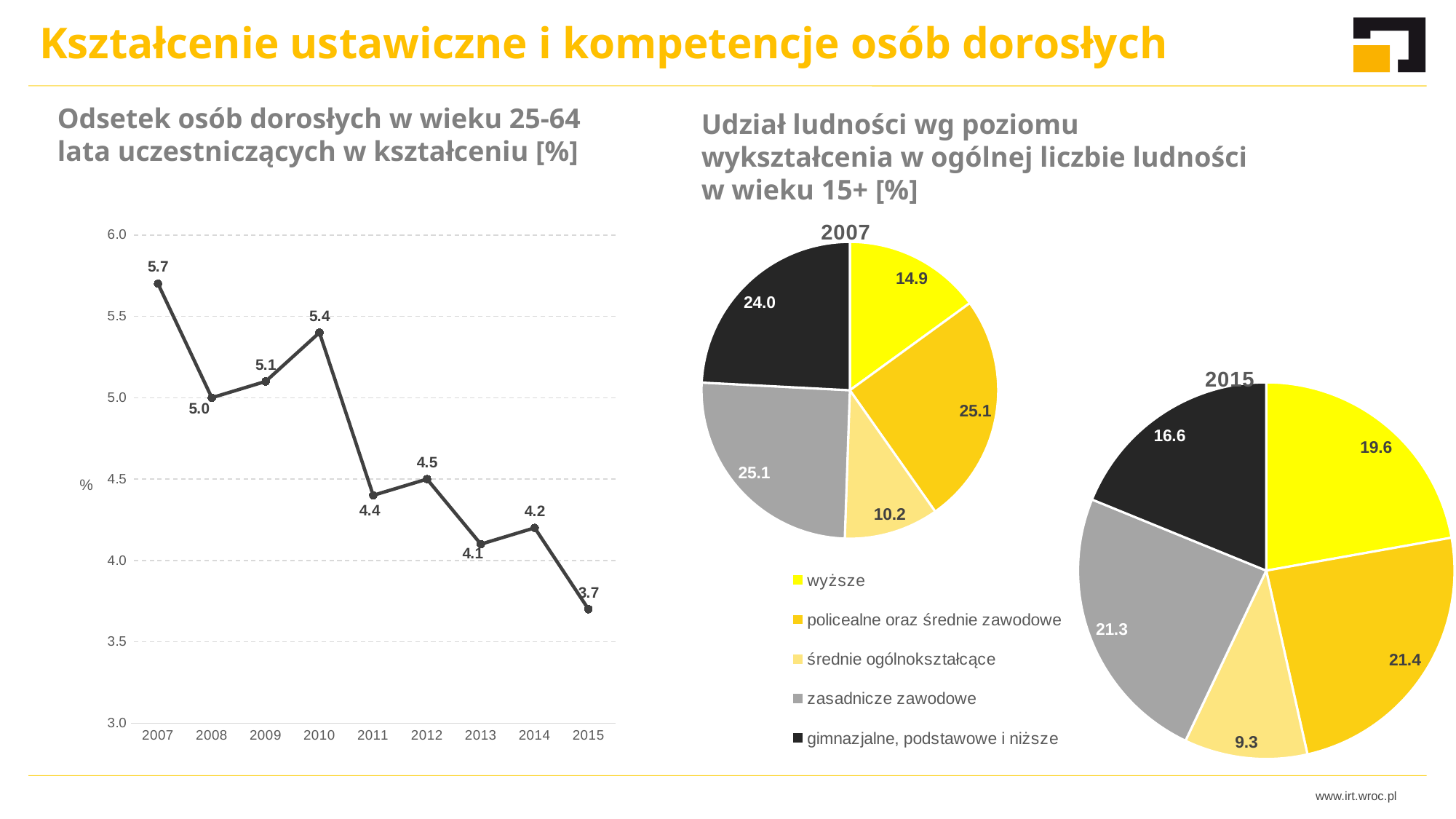
In the 2007 pie chart, what is the share for 'wyższe'? 14.9 In the line chart on the left, what was the value for 2015? 3.7 In the line chart on the left, how many years are plotted on the x axis? 9 In the line chart on the left, do the values generally rise or fall from 2007 to 2015? fall In the line chart on the left, is the value for 2010 greater or less than 5.0? greater In the 2015 pie chart, which category has the smallest slice? średnie ogólnokształcące In the line chart on the left, which year has the highest value? 2007 In the line chart on the left, what is the difference between the 2007 value and the 2015 value? 2.0 In the line chart on the left, what was the value for 2007? 5.7 In the 2015 pie chart, what is the share for 'średnie ogólnokształcące'? 9.3 How many categories does the legend of the pie charts list? 5 In the line chart on the left, which year has the lowest value? 2015